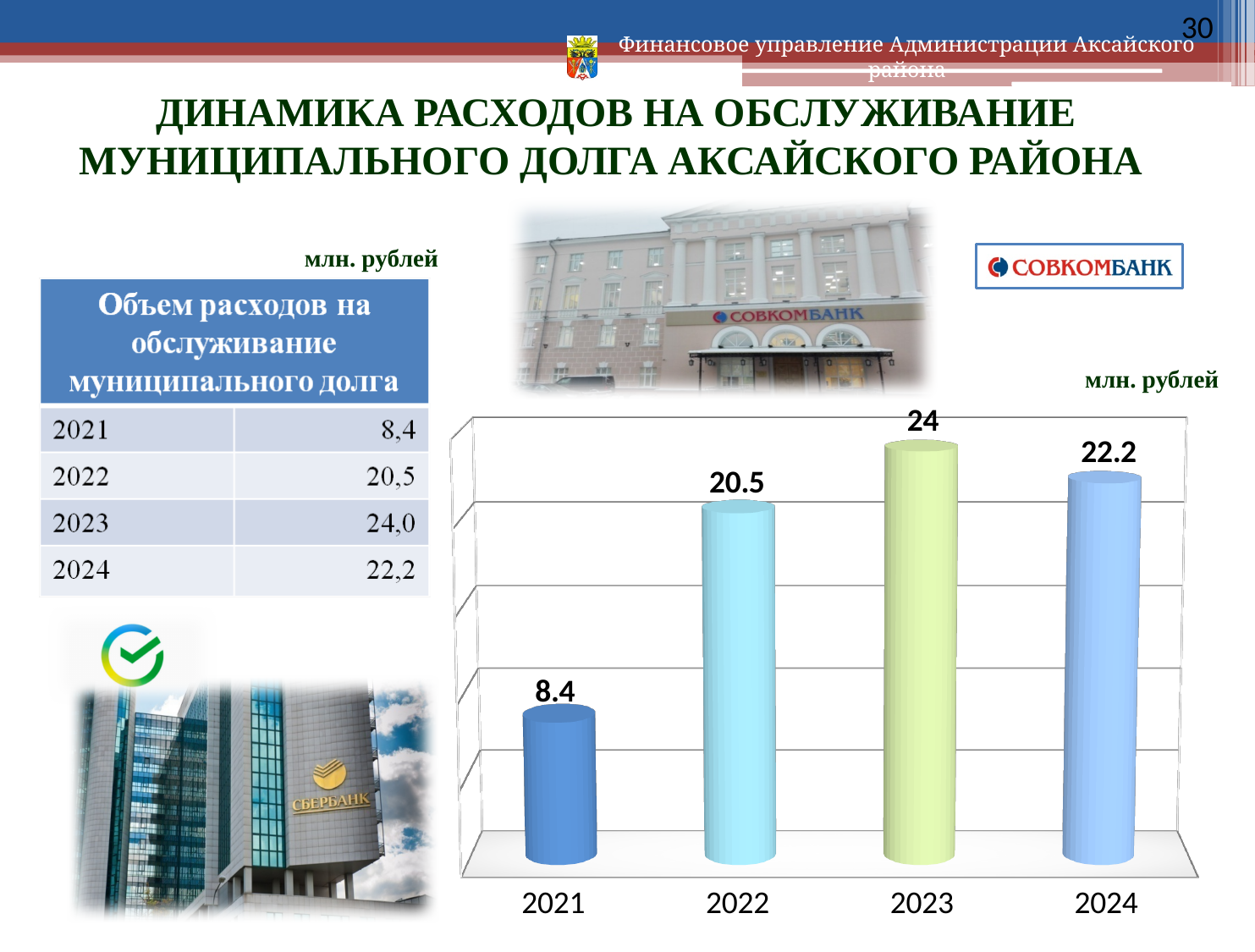
Which is larger on the chart, the value for 2022 or the value for 2024? 2024 Which year has the lowest value on the chart? 2021 What is the value shown for 2024 on the chart? 22.2 What is the value shown for 2023 on the chart? 24 What is the value shown for 2021 on the chart? 8.4 What is the value shown for 2022 on the chart? 20.5 What unit is indicated above the chart? млн. рублей How many years are plotted on the chart? 4 What is the difference between the values for 2024 and 2022 on the chart? 1.7 Which year has the highest value on the chart? 2023 What kind of chart is shown on the slide? bar chart What is the difference between the values for 2023 and 2021 on the chart? 15.6